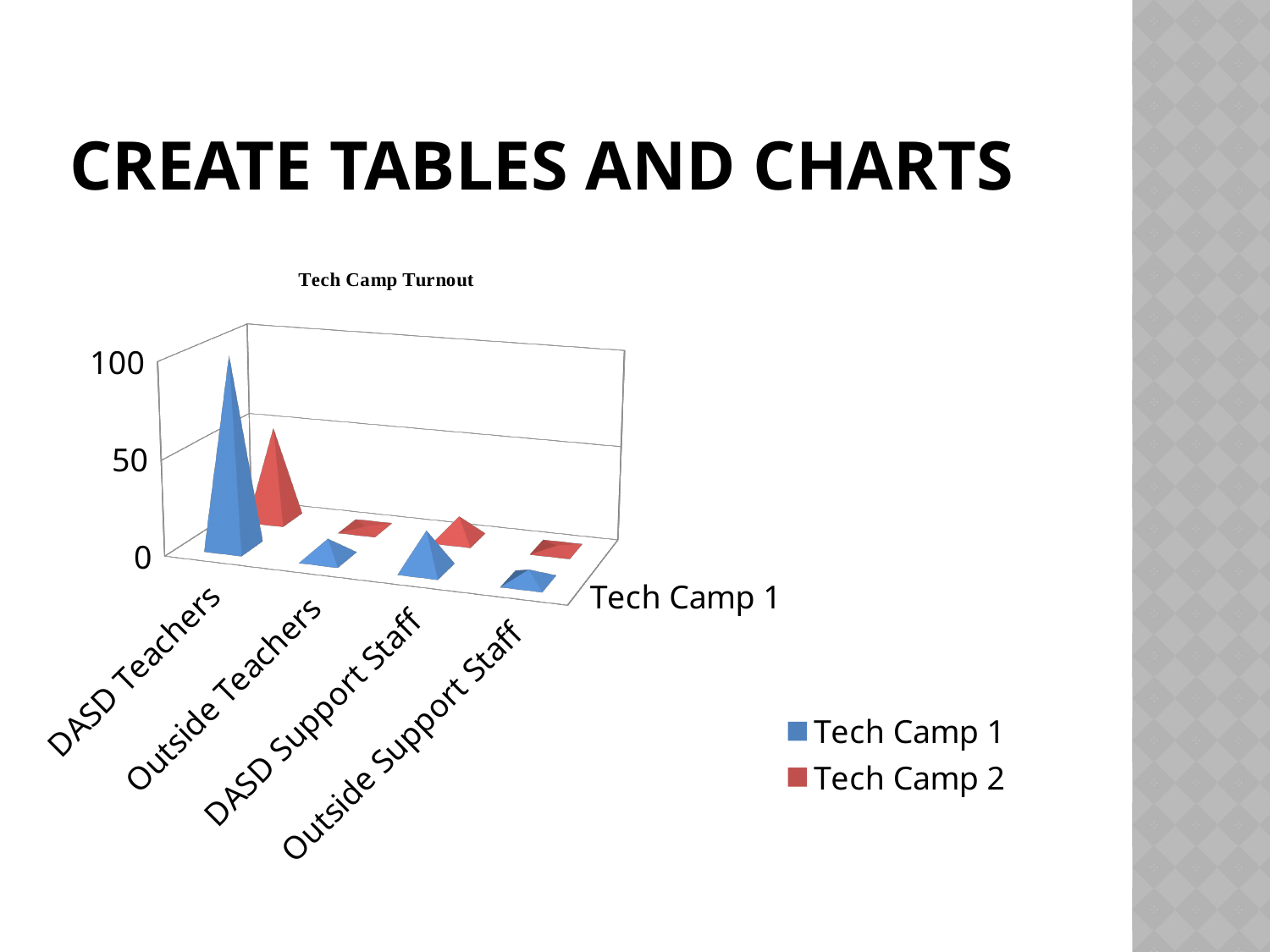
What type of chart is shown on the slide? bar chart Is the Tech Camp 2 value for Outside Support Staff greater or less than 50? less For DASD Teachers, which is larger: the Tech Camp 1 value or the Tech Camp 2 value? Tech Camp 1 Is the Tech Camp 1 value for Outside Teachers greater or less than 50? less How many series does the legend list? 2 What is the title of the chart? Tech Camp Turnout Is the Tech Camp 1 value for DASD Teachers greater or less than 50? greater What colour represents Tech Camp 2 in the legend? red Which category has the highest value for Tech Camp 1? DASD Teachers How many categories are shown on the x axis of the chart? 4 For Tech Camp 1, which is larger: DASD Teachers or DASD Support Staff? DASD Teachers Which category has the highest value for Tech Camp 2? DASD Teachers